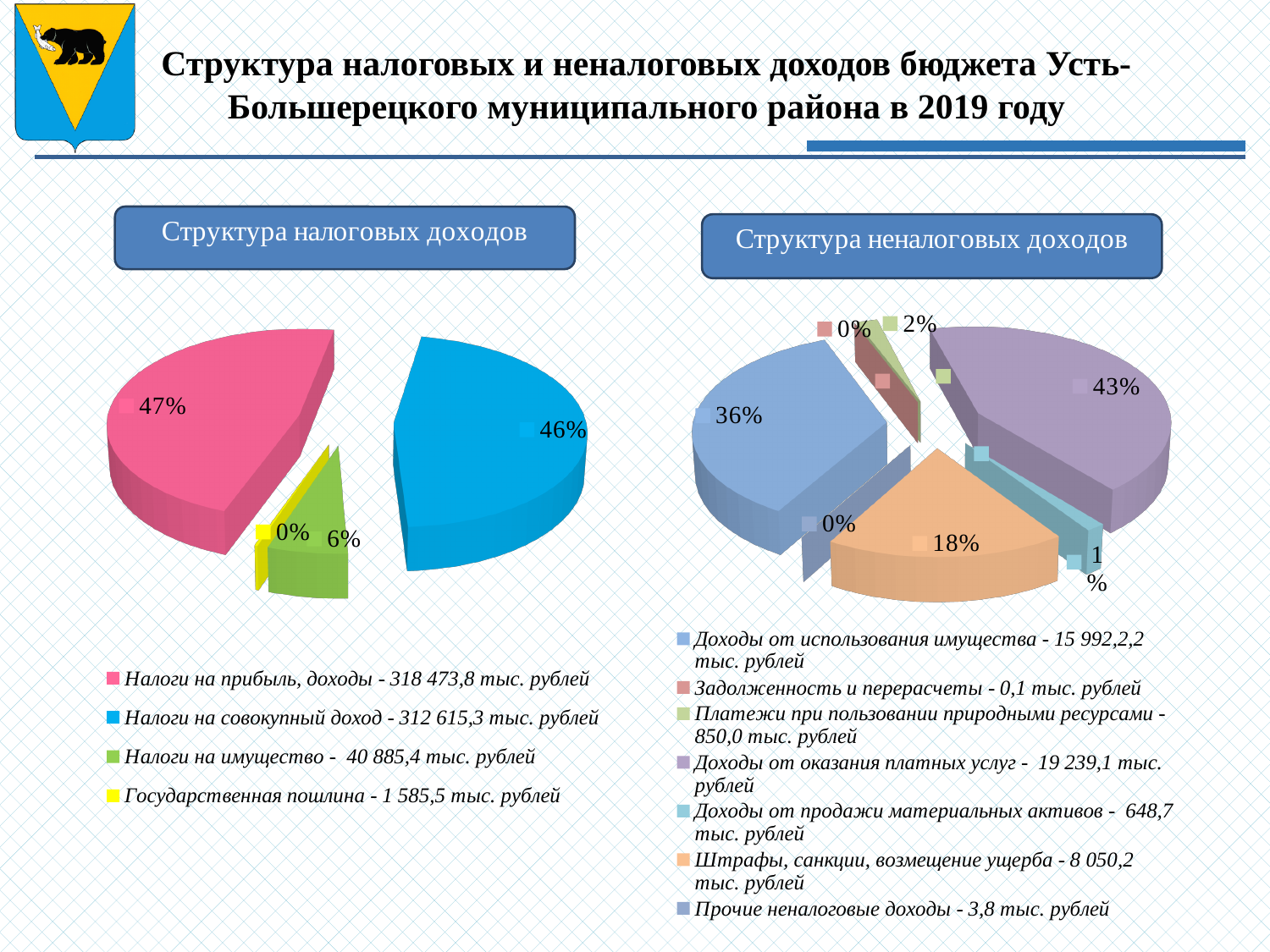
In the 'Структура налоговых доходов' chart, which category has the largest share? Налоги на прибыль, доходы In the 'Структура налоговых доходов' chart, what share is shown for 'Государственная пошлина'? 0% How many categories does the legend of the 'Структура неналоговых доходов' chart list? 7 In the 'Структура налоговых доходов' chart, what share is shown for 'Налоги на имущество'? 6% In the 'Структура неналоговых доходов' chart, what share is shown for 'Доходы от использования имущества'? 36% What kind of chart is used for 'Структура налоговых доходов'? pie chart How many categories does the legend of the 'Структура налоговых доходов' chart list? 4 In the 'Структура неналоговых доходов' chart, what is the difference between the shares of 'Доходы от оказания платных услуг' and 'Доходы от использования имущества'? 7% In the 'Структура неналоговых доходов' chart, which category has the largest share? Доходы от оказания платных услуг